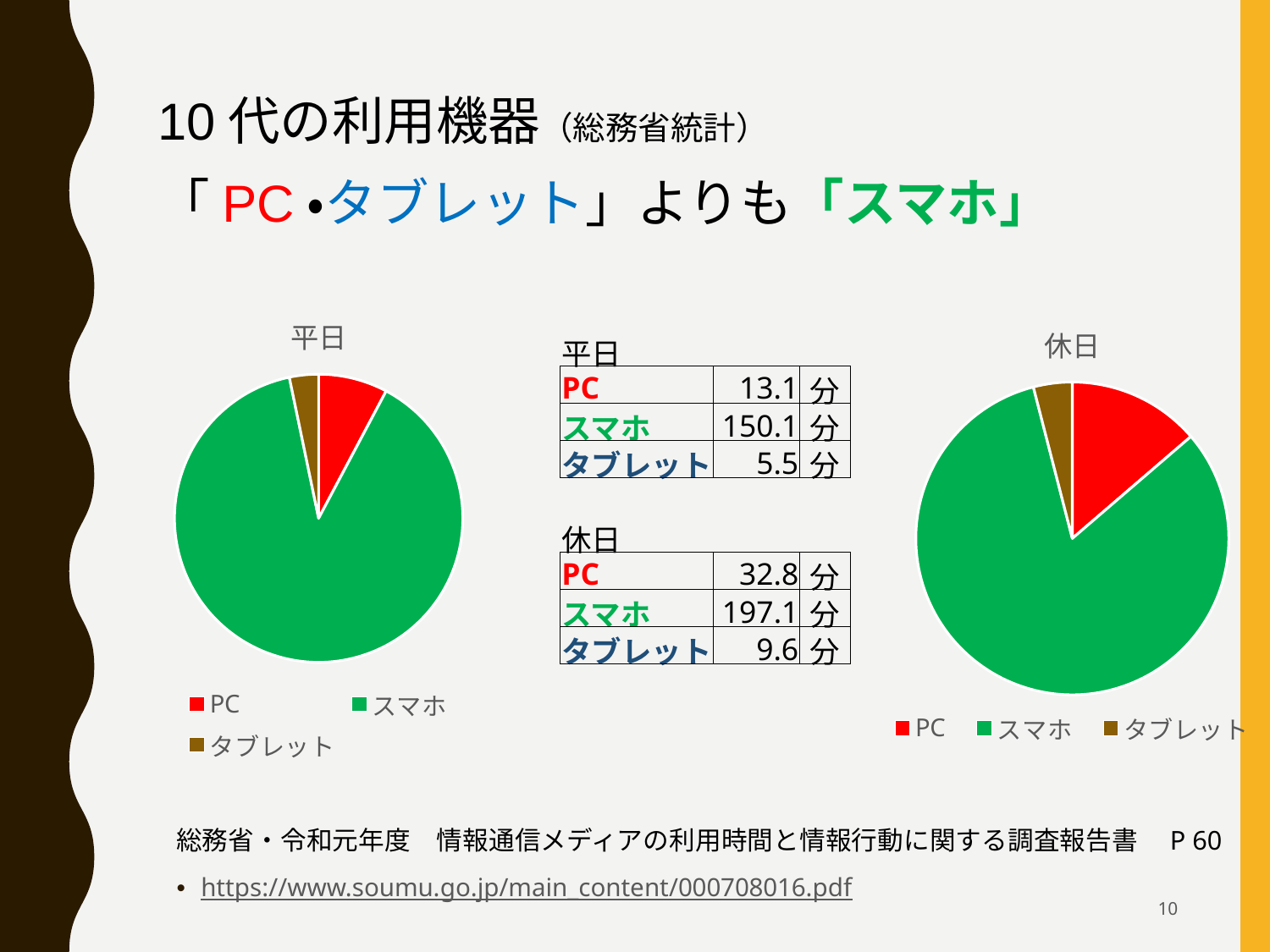
In the 休日 pie chart, what is the value for PC? 32.8 分 In the 平日 pie chart, what is the value for PC? 13.1 分 In the 休日 pie chart, what is the value for タブレット? 9.6 分 In the 平日 pie chart, what colour is the スマホ slice? green What is the total of the three values shown for 休日? 239.5 分 What kind of chart is the 平日 chart? pie chart How many categories does the 休日 pie chart show? 3 In the 平日 pie chart, what is the difference between the values for スマホ and PC? 137.0 分 In the 休日 pie chart, which is larger, the value for PC or the value for タブレット? PC In the 休日 pie chart, which category has the smallest slice? タブレット In the 平日 pie chart, what is the value for スマホ? 150.1 分 In the 平日 pie chart, which category has the largest slice? スマホ